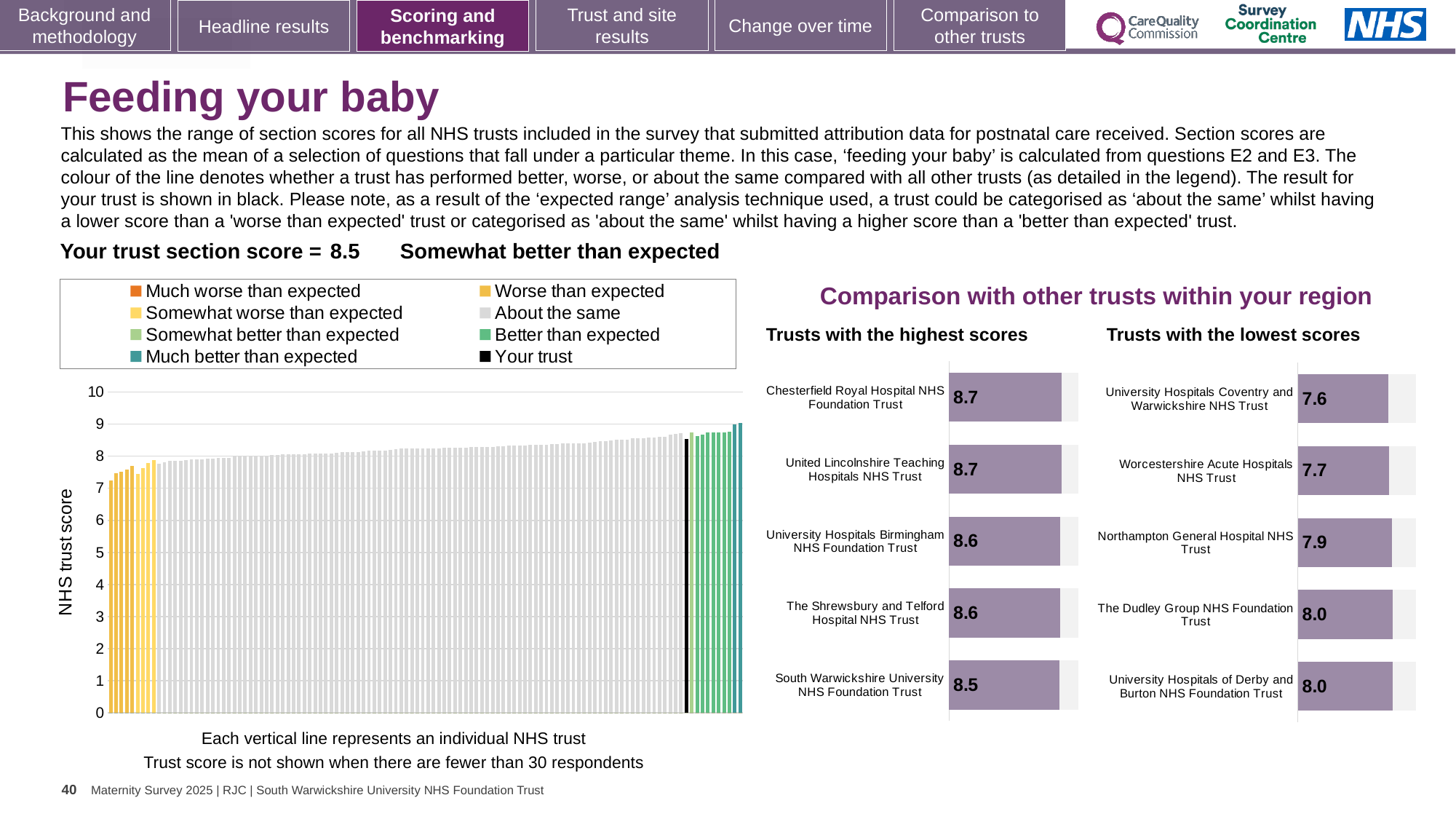
In the 'Trusts with the highest scores' chart, what is the score for Chesterfield Royal Hospital NHS Foundation Trust? 8.7 How many trusts are listed in the 'Trusts with the highest scores' chart? 5 In the large chart on the left, is the value of the black 'Your trust' bar greater or less than 8? greater In the 'Trusts with the lowest scores' chart, which has the higher score: Worcestershire Acute Hospitals NHS Trust or Northampton General Hospital NHS Trust? Northampton General Hospital NHS Trust In the 'Trusts with the lowest scores' chart, which trust has the lowest score? University Hospitals Coventry and Warwickshire NHS Trust What type of chart is the large chart on the left with the 'NHS trust score' axis? Bar chart In the large chart on the left, do the bar values rise or fall from left to right along the x axis? Rise In the 'Trusts with the lowest scores' chart, what is the difference between the score for University Hospitals of Derby and Burton NHS Foundation Trust and the score for University Hospitals Coventry and Warwickshire NHS Trust? 0.4 In the 'Trusts with the lowest scores' chart, what is the score for Worcestershire Acute Hospitals NHS Trust? 7.7 In the 'Trusts with the highest scores' chart, what is the score for South Warwickshire University NHS Foundation Trust? 8.5 In the 'Trusts with the highest scores' chart, what is the difference between the score for Chesterfield Royal Hospital NHS Foundation Trust and the score for South Warwickshire University NHS Foundation Trust? 0.2 How many entries does the legend above the large chart on the left list? 8